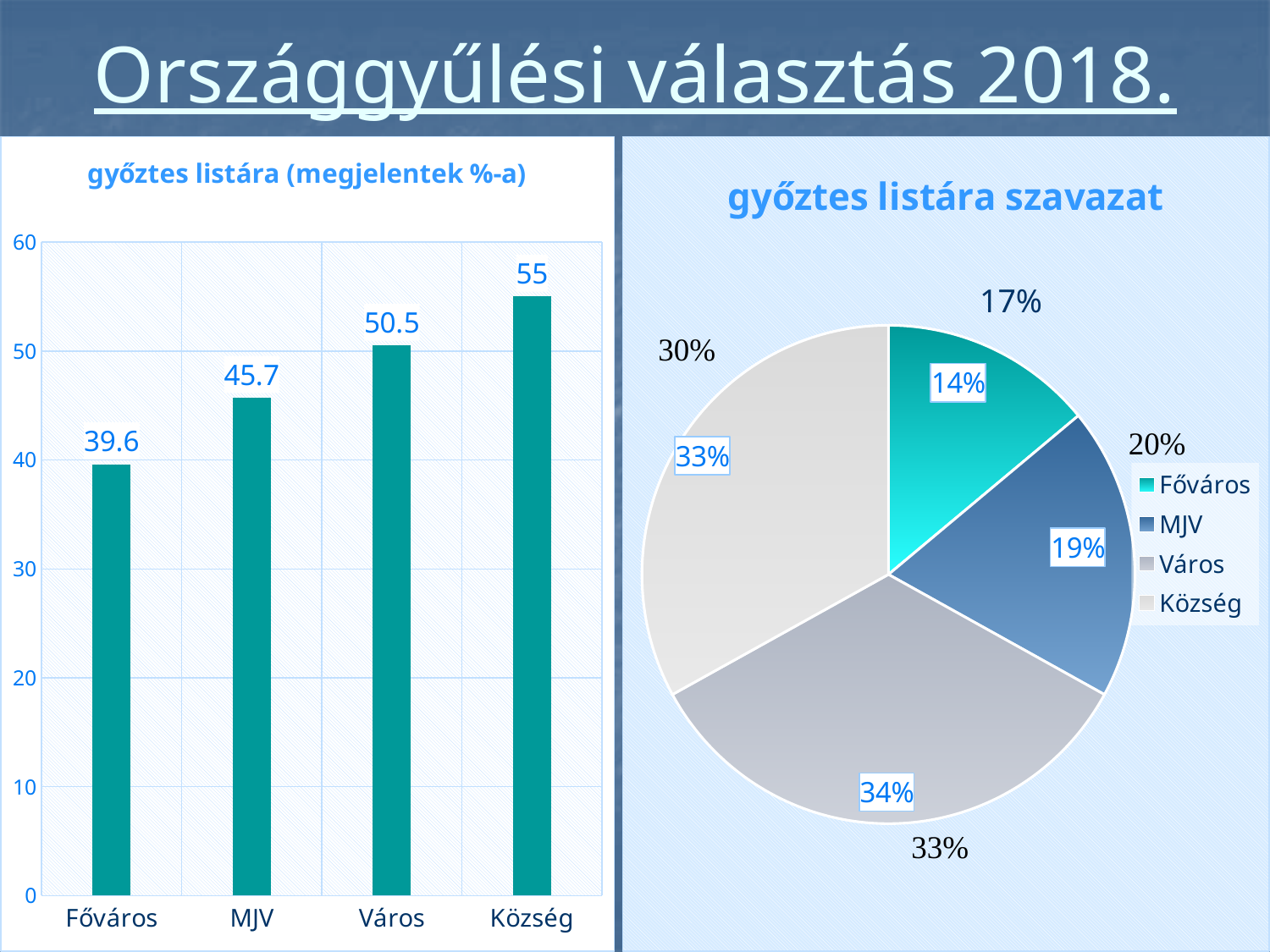
In the pie chart titled 'győztes listára szavazat', which slice is the smallest? Főváros In the bar chart titled 'győztes listára (megjelentek %-a)', what is the value for MJV? 45.7 In the bar chart titled 'győztes listára (megjelentek %-a)', what is the value for Főváros? 39.6 How many entries does the legend of the pie chart titled 'győztes listára szavazat' list? 4 In the bar chart on the left, do the values rise or fall from Főváros to Község along the x axis? rise How many categories are shown in the bar chart on the left? 4 In the bar chart on the left, which is larger: the value for Város or the value for MJV? Város In the bar chart on the left, which category has the lowest value? Főváros What kind of chart is the chart titled 'győztes listára szavazat'? pie chart In the bar chart on the left, which category has the highest value? Község In the bar chart on the left, what is the difference between the values for Község and Főváros? 15.4 In the bar chart titled 'győztes listára (megjelentek %-a)', what is the value for Község? 55